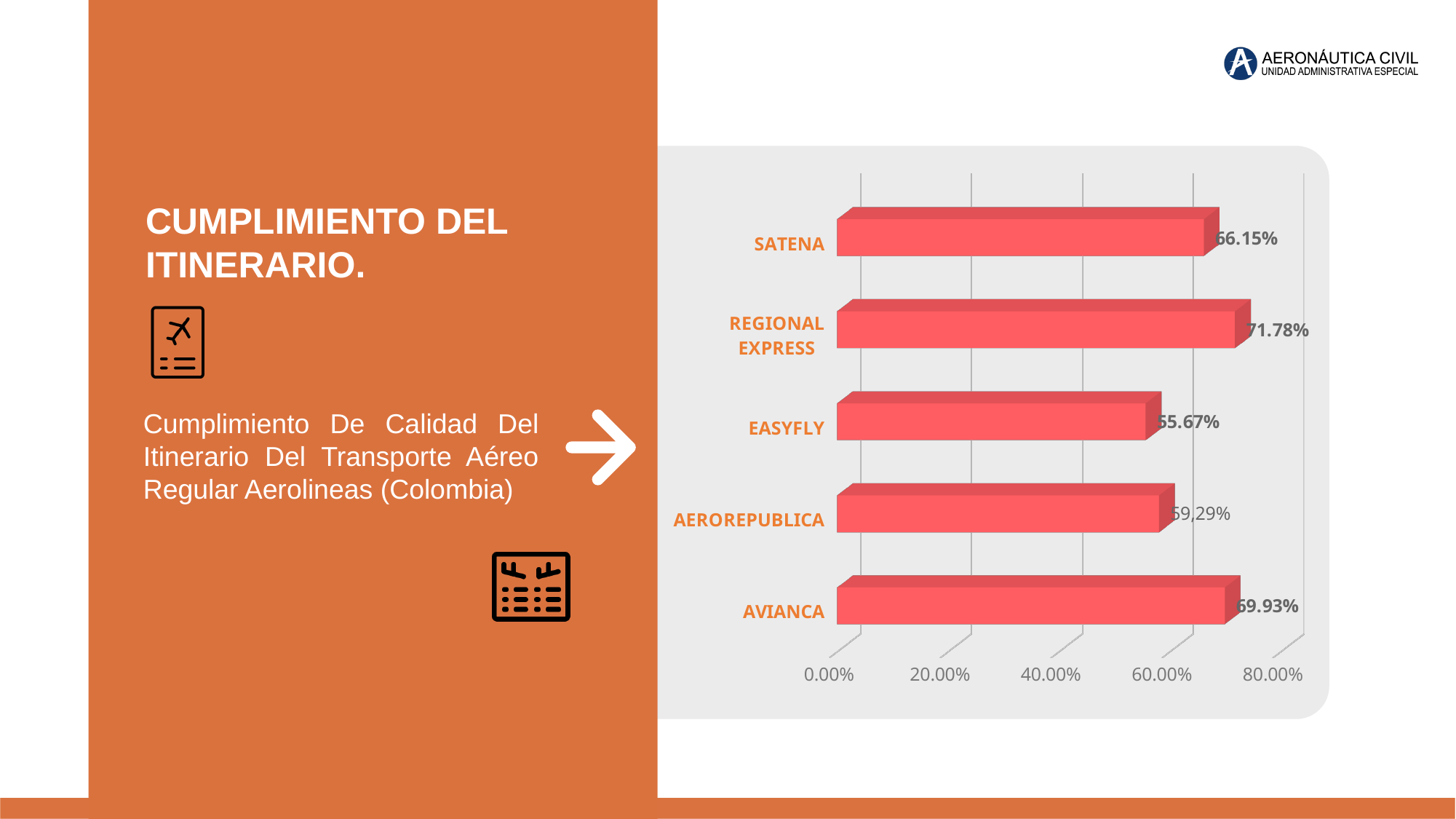
What is the value for AVIANCA? 69.93% What is the value for REGIONAL EXPRESS? 71.78% What is the difference between the values for REGIONAL EXPRESS and EASYFLY? 16.11 percentage points Which airline has the highest value? REGIONAL EXPRESS What is the value for EASYFLY? 55.67% How many airlines are shown in the chart? 5 Which airline has the lowest value? EASYFLY What is the value for SATENA? 66.15% Is the value for AEROREPUBLICA greater or less than 60.00%? less What kind of chart is shown on the slide? Bar chart Which is larger, the value for AVIANCA or the value for SATENA? AVIANCA What is the maximum value shown on the horizontal axis? 80.00%